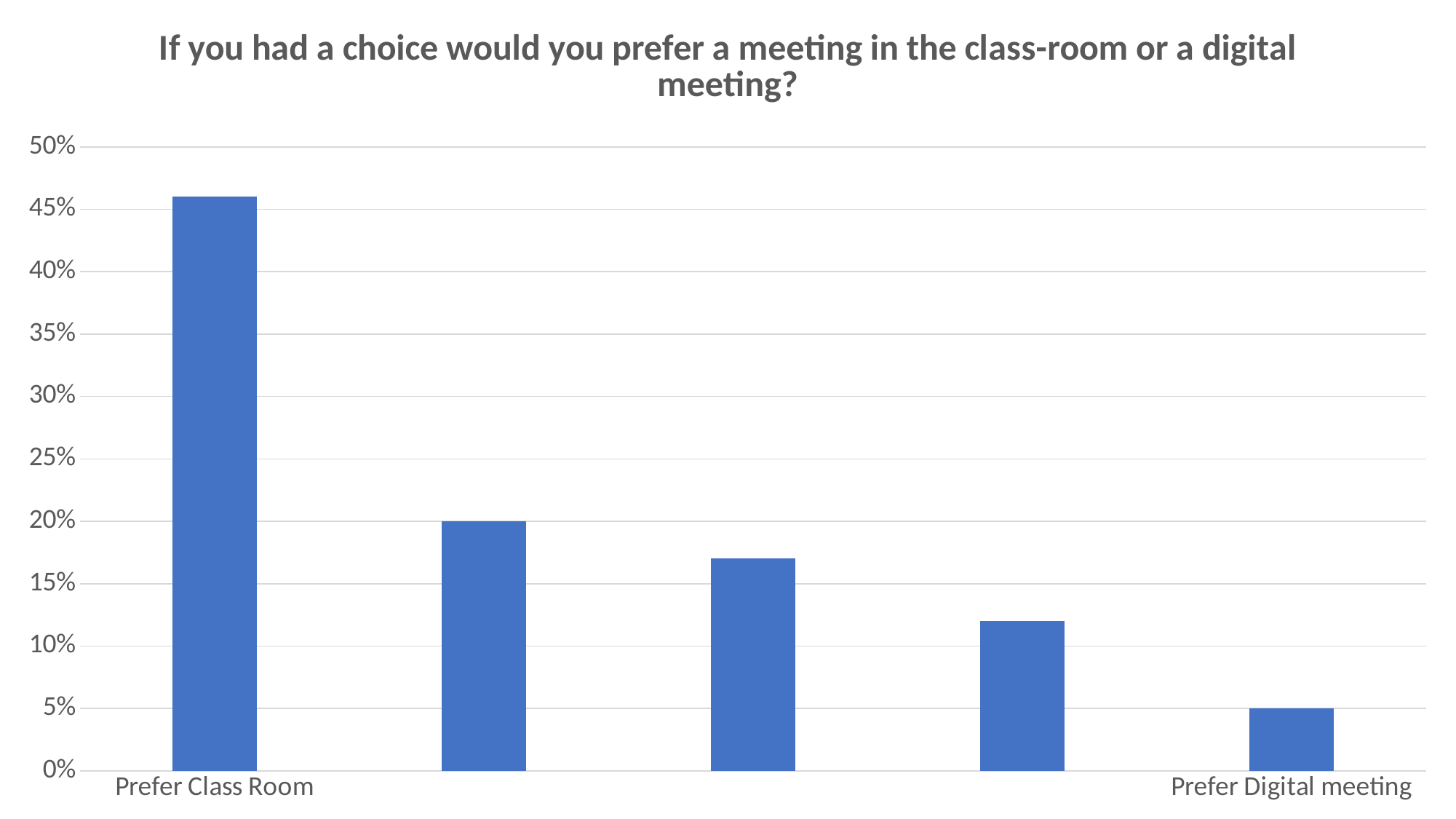
Which category has the highest value? Prefer Class Room Do the bar values rise or fall from left to right across the chart? Fall Which category has the lowest value? Prefer Digital meeting How many bars are plotted in the chart? 5 What is the value for Prefer Digital meeting? 5% What colour are the bars in the chart? Blue Which is larger, the value for Prefer Class Room or the value for Prefer Digital meeting? Prefer Class Room What is the title of the chart? If you had a choice would you prefer a meeting in the class-room or a digital meeting? What type of chart is shown on the slide? Bar chart Is the value for Prefer Digital meeting greater or less than 10%? less What is the highest value shown on the vertical axis? 50% Is the value for Prefer Class Room greater or less than 40%? greater